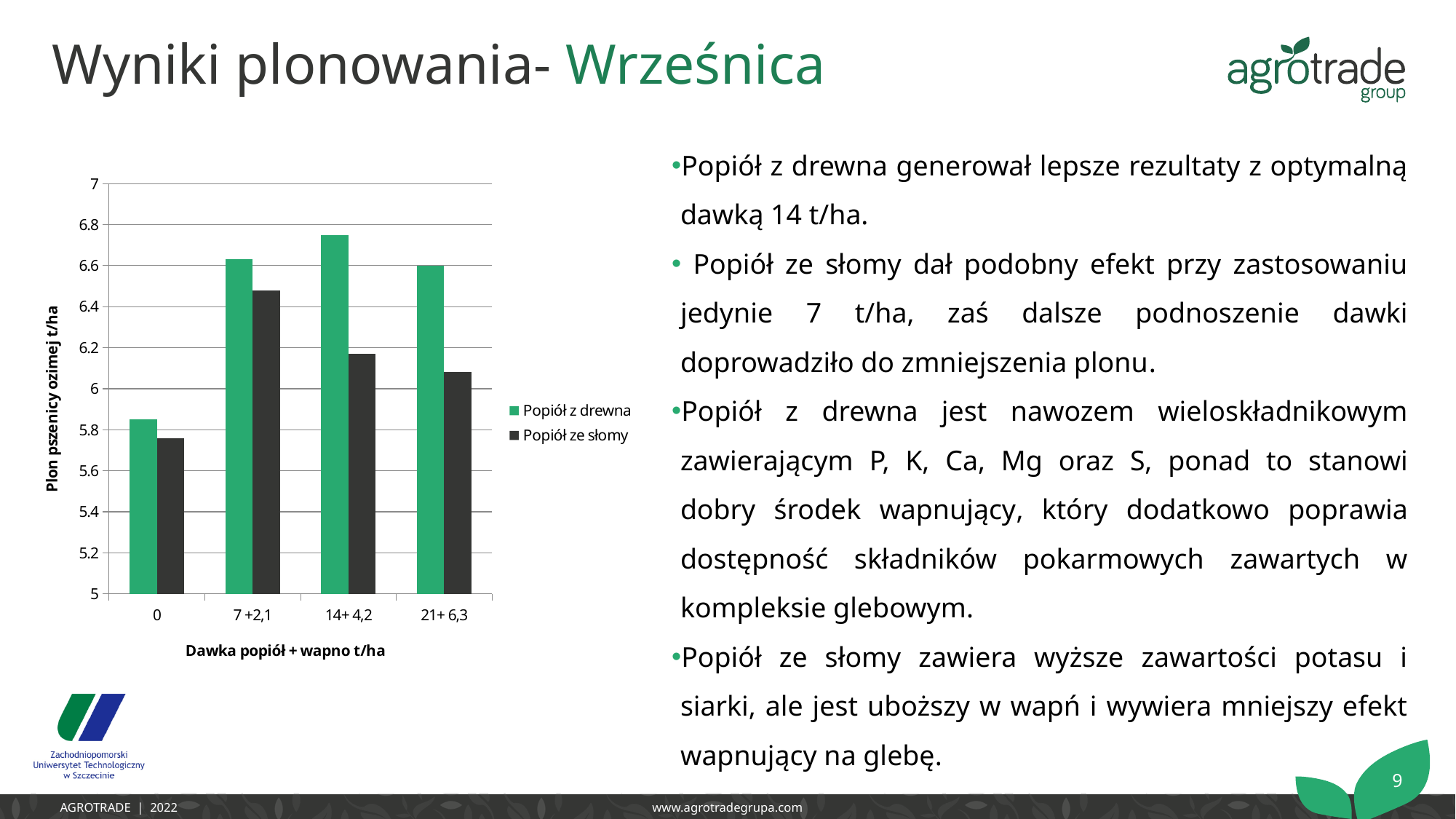
For which dose category is the Popiół ze słomy bar highest? 7 +2,1 What is the title of the chart's vertical axis? Plon pszenicy ozimej t/ha How many series does the chart legend list? 2 For which dose category is the Popiół ze słomy bar lowest? 0 For which dose category is the Popiół z drewna bar highest? 14+ 4,2 Is the value for Popiół ze słomy at dose 21+ 6,3 greater or less than 6.2? less Is the value for Popiół z drewna at dose 0 greater or less than 6? less What kind of chart is shown on the slide? bar chart Do the Popiół ze słomy values rise or fall from the 7 +2,1 dose to the 21+ 6,3 dose? fall How many dose categories are shown on the x axis of the chart? 4 Is the value for Popiół z drewna at dose 14+ 4,2 greater or less than 6.6? greater At the 21+ 6,3 dose, which series has the larger value, Popiół z drewna or Popiół ze słomy? Popiół z drewna